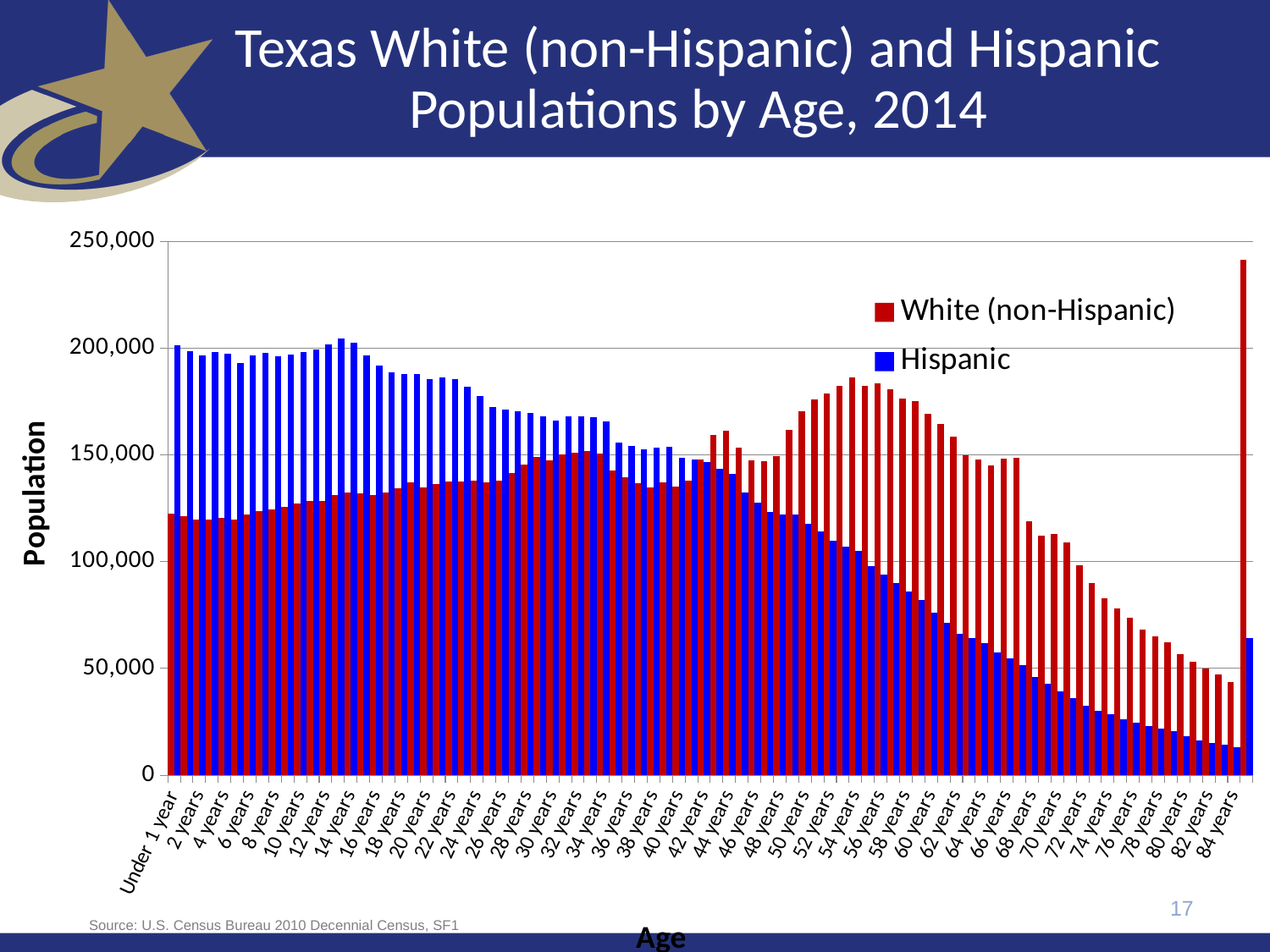
How many series does the legend list? 2 At 2 years, which series has the larger value, White (non-Hispanic) or Hispanic? Hispanic At 60 years, which series has the larger value, White (non-Hispanic) or Hispanic? White (non-Hispanic) What are the two series named in the legend? White (non-Hispanic) and Hispanic Is the Hispanic value for 60 years greater or less than 100,000? less Do the Hispanic values generally rise or fall along the x axis from 14 years to 84 years? fall Is the Hispanic value for 20 years greater or less than 150,000? greater Is the Hispanic value for 80 years greater or less than 50,000? less What is the label on the vertical axis? Population What kind of chart is shown on the slide? bar chart